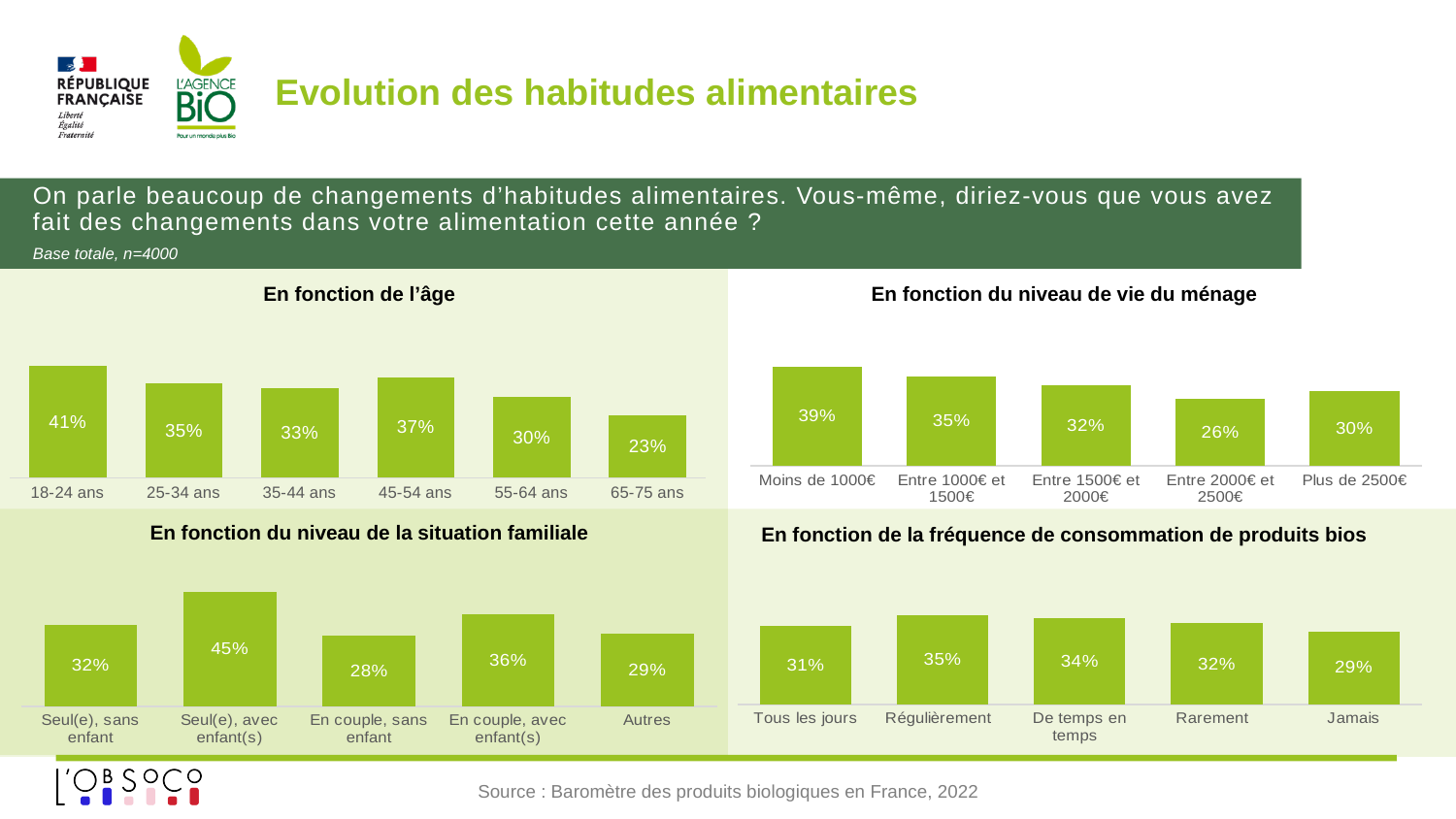
In the 'En fonction du niveau de vie du ménage' chart, what is the value for 'Plus de 2500€'? 30% In the 'En fonction de l'âge' chart, which age group has the lowest value? 65-75 ans In the 'En fonction de l'âge' chart, what is the value for 18-24 ans? 41% In the 'En fonction de l'âge' chart, how many age categories are shown? 6 In the 'En fonction du niveau de la situation familiale' chart, what is the value for 'Seul(e), avec enfant(s)'? 45% In the 'En fonction du niveau de vie du ménage' chart, which category has the highest value? Moins de 1000€ What type of chart is used in the 'En fonction de la fréquence de consommation de produits bios' chart? Bar chart In the 'En fonction du niveau de la situation familiale' chart, which category has the lowest value? En couple, sans enfant In the 'En fonction du niveau de vie du ménage' chart, which is larger: 'Entre 1500€ et 2000€' or 'Entre 2000€ et 2500€'? Entre 1500€ et 2000€ In the 'En fonction de la fréquence de consommation de produits bios' chart, what is the difference between 'Régulièrement' and 'Jamais'? 6 percentage points In the 'En fonction de la fréquence de consommation de produits bios' chart, what is the value for 'Régulièrement'? 35% In the 'En fonction de l'âge' chart, what is the difference between 18-24 ans and 65-75 ans? 18 percentage points